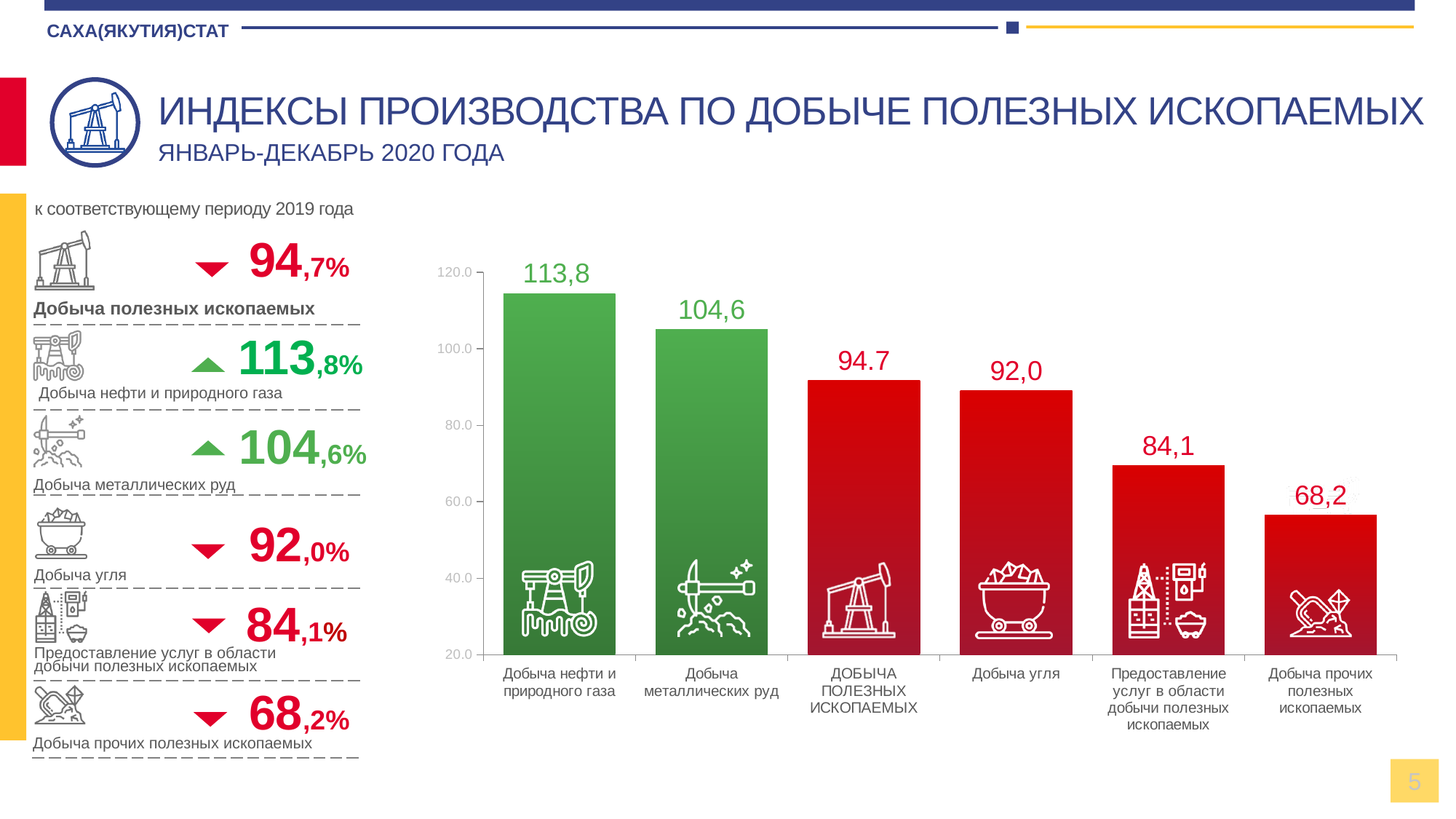
Which category has the highest value? Добыча нефти и природного газа What is the value for Добыча нефти и природного газа? 113,8 What colour are the bars for categories with values above 100? green Which is larger: the value for Добыча угля or the value for Предоставление услуг в области добычи полезных ископаемых? Добыча угля Which category has the lowest value? Добыча прочих полезных ископаемых What is the value for Добыча прочих полезных ископаемых? 68,2 What kind of chart is shown on the slide? bar chart How many categories are shown in the chart? 6 What is the difference between the values for Добыча нефти и природного газа and Добыча металлических руд? 9,2 Is the value for Предоставление услуг в области добычи полезных ископаемых greater or less than 100? less What is the value for Добыча металлических руд? 104,6 What is the value for Добыча угля? 92,0